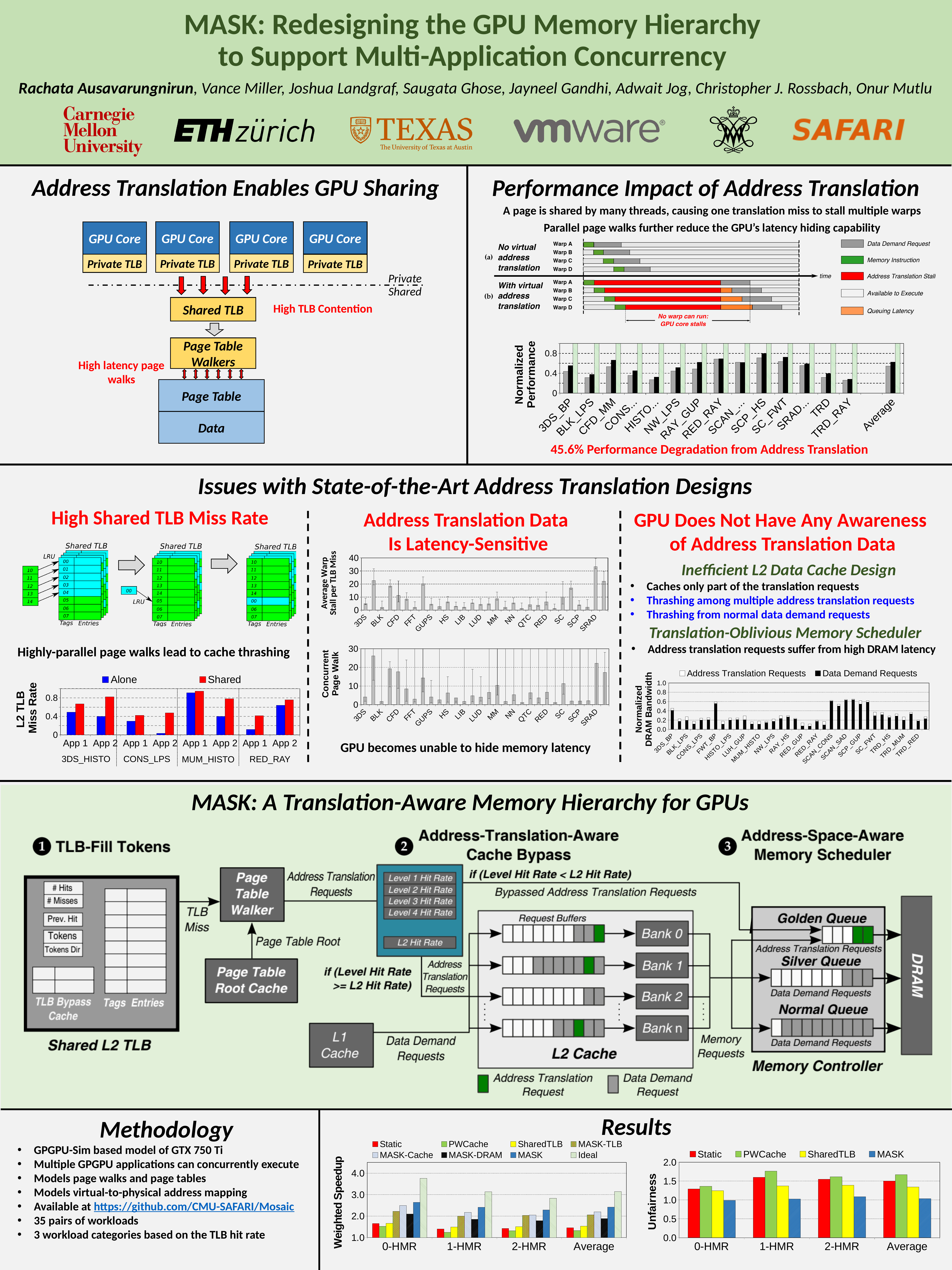
In the Normalized DRAM Bandwidth chart, what kind of chart is it? bar chart In the Concurrent Page Walk chart, is the value for BLK greater or less than 20? less In the Average Warp Stall per TLB Miss chart, which application has the highest value? SRAD In the Unfairness chart, is the PWCache value for 1-HMR greater or less than 1.5? greater In the Weighted Speedup chart, how many series does the legend list? 8 In the L2 TLB Miss Rate chart, which is larger for App 2 of 3DS_HISTO: Alone or Shared? Shared In the Unfairness chart, how many workload categories are shown on the x axis? 4 In the Unfairness chart, which series has the lowest value for 1-HMR? MASK In the Weighted Speedup chart, is the Ideal value for 0-HMR greater or less than 3.0? greater In the Unfairness chart, how many series does the legend list? 4 In the Weighted Speedup chart, which is larger for Average: MASK or Static? MASK In the Weighted Speedup chart, which series has the highest value for 0-HMR? Ideal